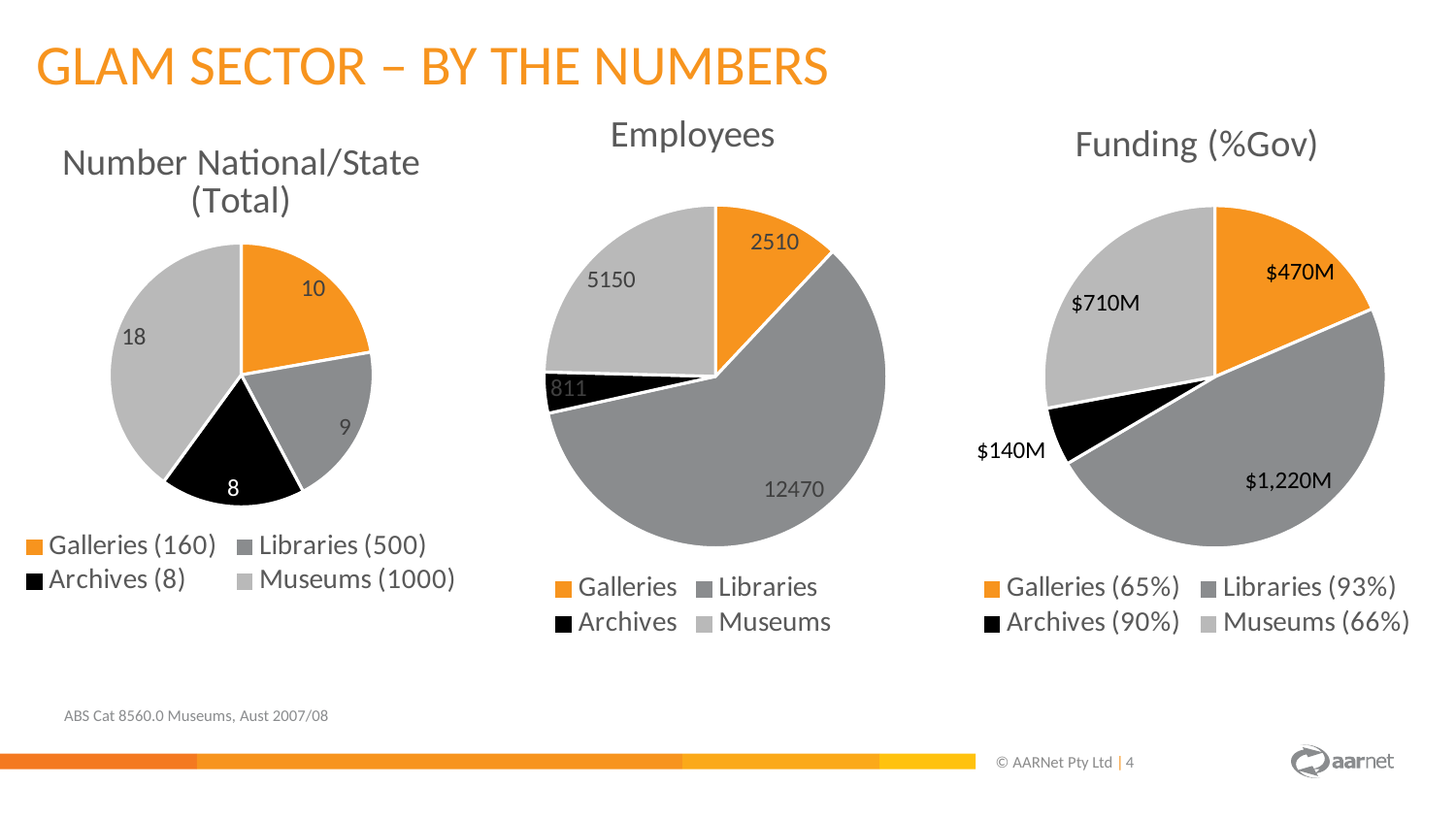
In the Employees chart, how many employees are shown for Libraries? 12470 In the Funding (%Gov) chart, what is the difference between the Libraries value and the Galleries value? $750M In the Funding (%Gov) chart, what percentage is shown next to Libraries in the legend? 93% How many slices does the Employees pie chart have? 4 In the Funding (%Gov) chart, what is the value for Museums? $710M In the Employees chart, what is the difference between Museums and Galleries? 2640 In the Employees chart, which category has the smallest slice? Archives In the Number National/State (Total) chart, which category has the largest slice? Museums In the Number National/State (Total) chart, what is the value for Archives? 8 In the Number National/State (Total) chart, what share of the pie does Museums represent? 40% What type of chart is used for Funding (%Gov)? Pie chart In the Funding (%Gov) chart, which is larger, Galleries or Archives? Galleries